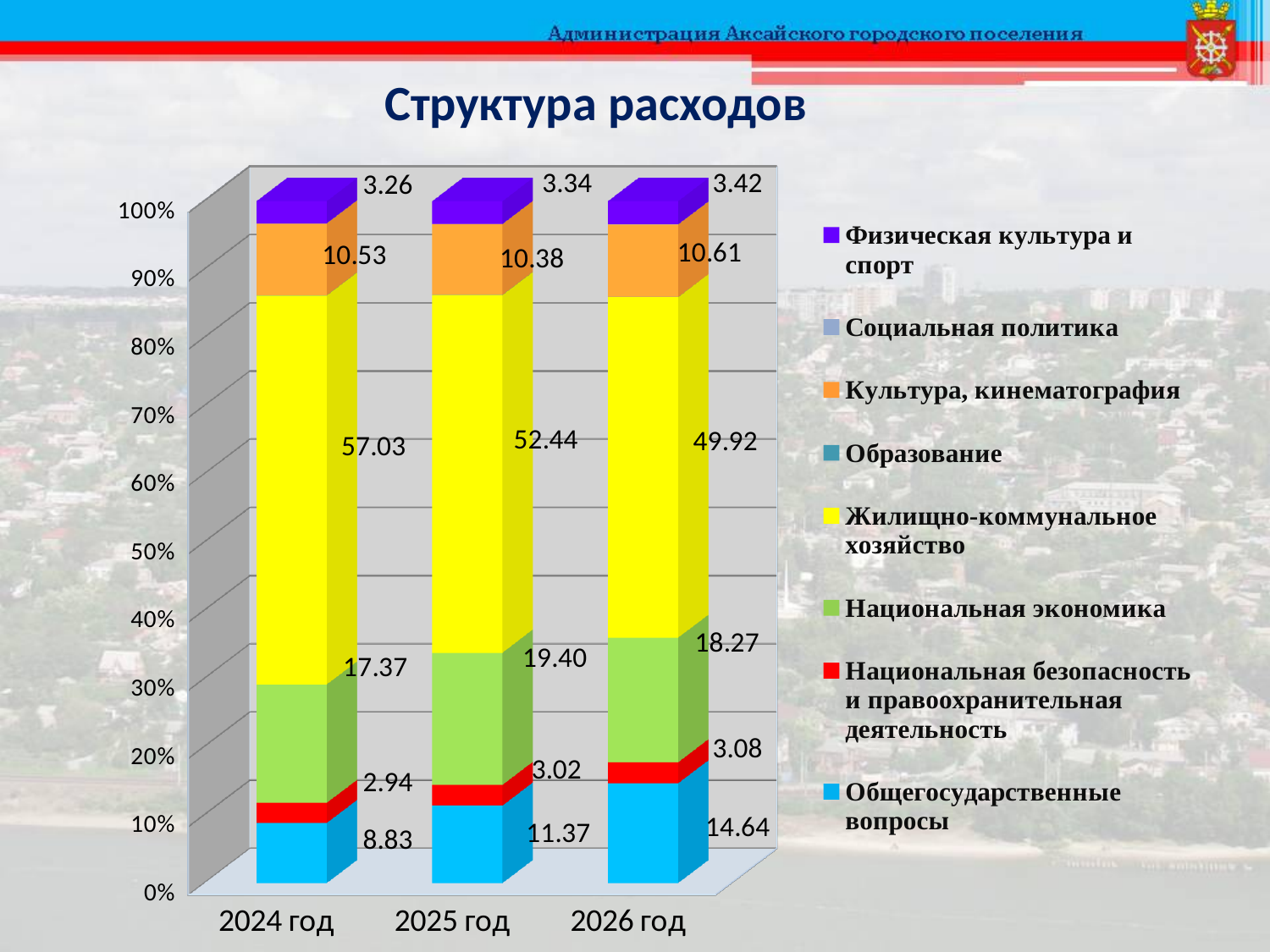
In which year is the value for Общегосударственные вопросы the lowest? 2024 год What is the value for Национальная экономика in 2025 год? 19.40 What is the difference between the Жилищно-коммунальное хозяйство values for 2024 год and 2026 год? 7.11 Does the value for Общегосударственные вопросы rise or fall from 2024 год to 2026 год? Rise What is the value for Физическая культура и спорт in 2025 год? 3.34 How many years are shown on the x axis? 3 What kind of chart is shown on the slide? Stacked bar chart In which year is the value for Жилищно-коммунальное хозяйство the highest? 2024 год How many series does the legend list? 8 What is the value for Жилищно-коммунальное хозяйство in 2024 год? 57.03 Which is larger: Культура, кинематография in 2024 год or in 2025 год? 2024 год What is the value for Общегосударственные вопросы in 2026 год? 14.64